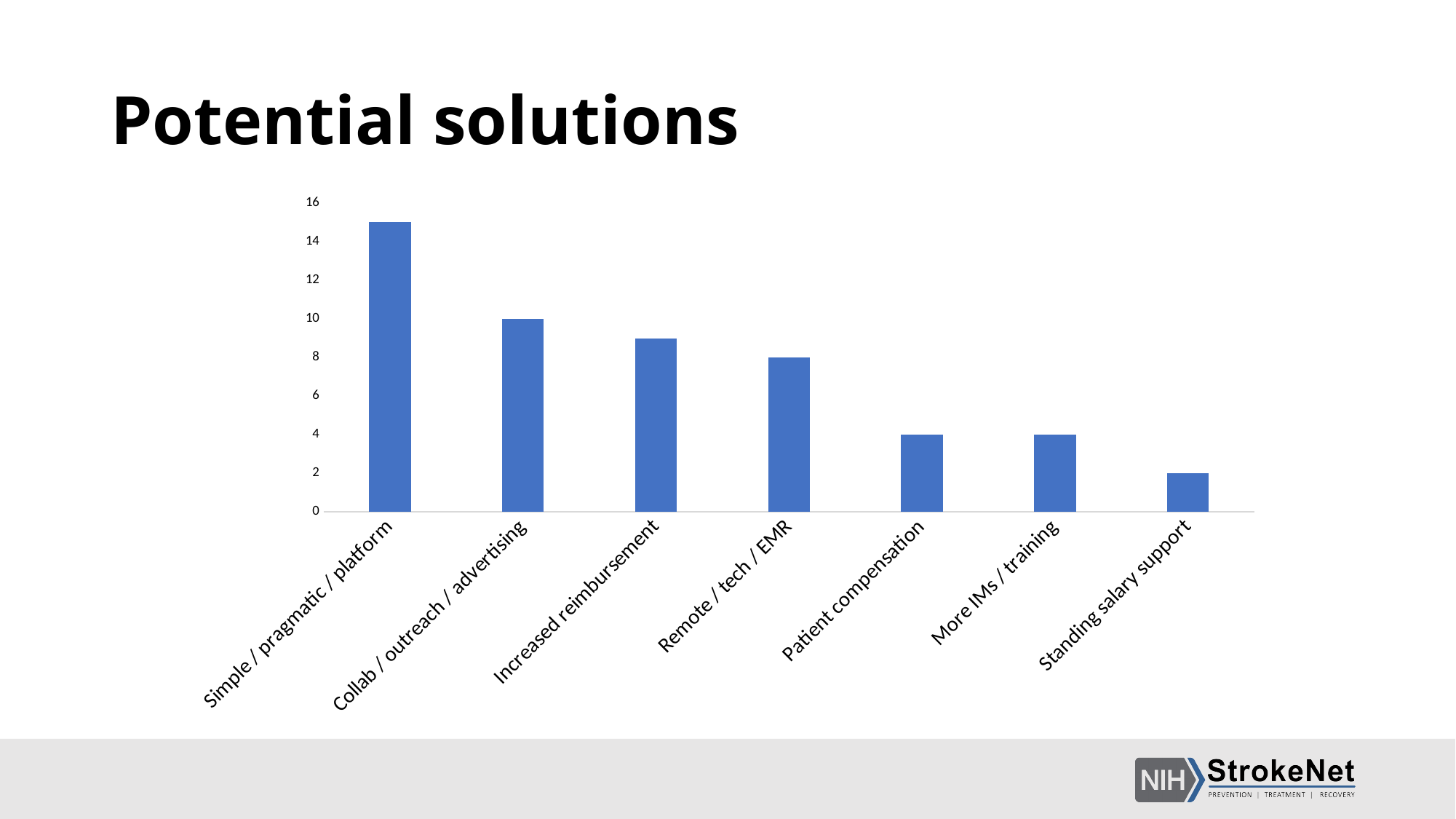
Which is larger, the value for Collab / outreach / advertising or the value for Remote / tech / EMR? Collab / outreach / advertising Which category has the lowest bar? Standing salary support What is the title of the slide containing the chart? Potential solutions Which category has the highest bar? Simple / pragmatic / platform Do the bar values rise or fall from left to right along the x axis? fall What kind of chart is shown on the slide? bar chart Is the value for Increased reimbursement greater or less than 8? greater Is the value for Simple / pragmatic / platform greater or less than 14? greater What is the value for Collab / outreach / advertising? 10 Is the value for Standing salary support greater or less than 4? less How many categories are shown on the x axis of the chart? 7